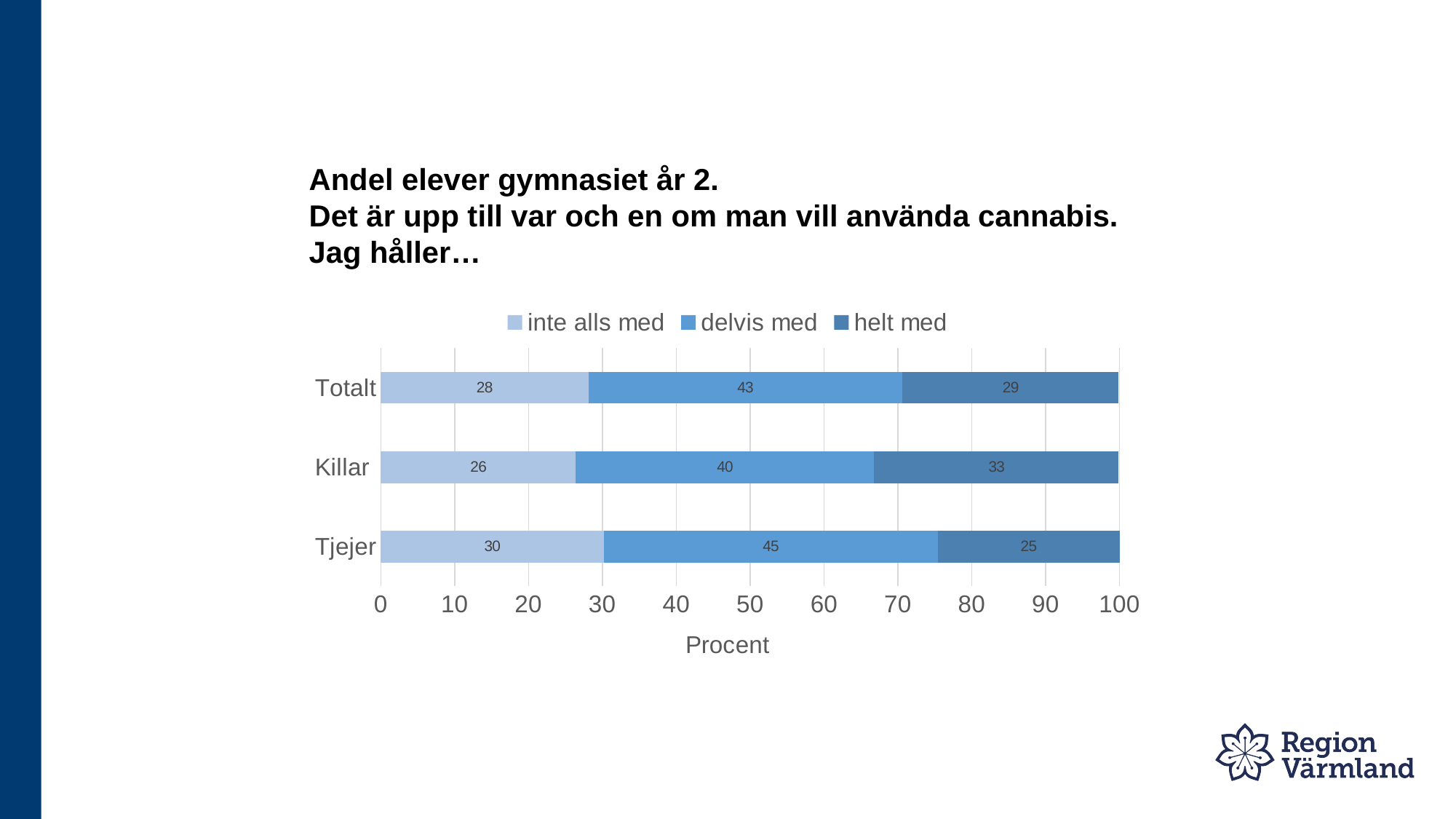
Which category has the lowest value for "inte alls med"? Killar What kind of chart is shown? Stacked bar chart Which category has the highest value for "helt med"? Killar How many series does the legend list? 3 What is the total of the stacked bar for Killar? 99 What is the value for "helt med" for Killar? 33 Which is larger: the "helt med" value for Totalt or for Tjejer? Totalt What is the label of the x axis? Procent What is the value for "inte alls med" for Totalt? 28 How many categories are shown on the y axis? 3 What is the difference between the "delvis med" values for Tjejer and Killar? 5 What is the value for "delvis med" for Tjejer? 45